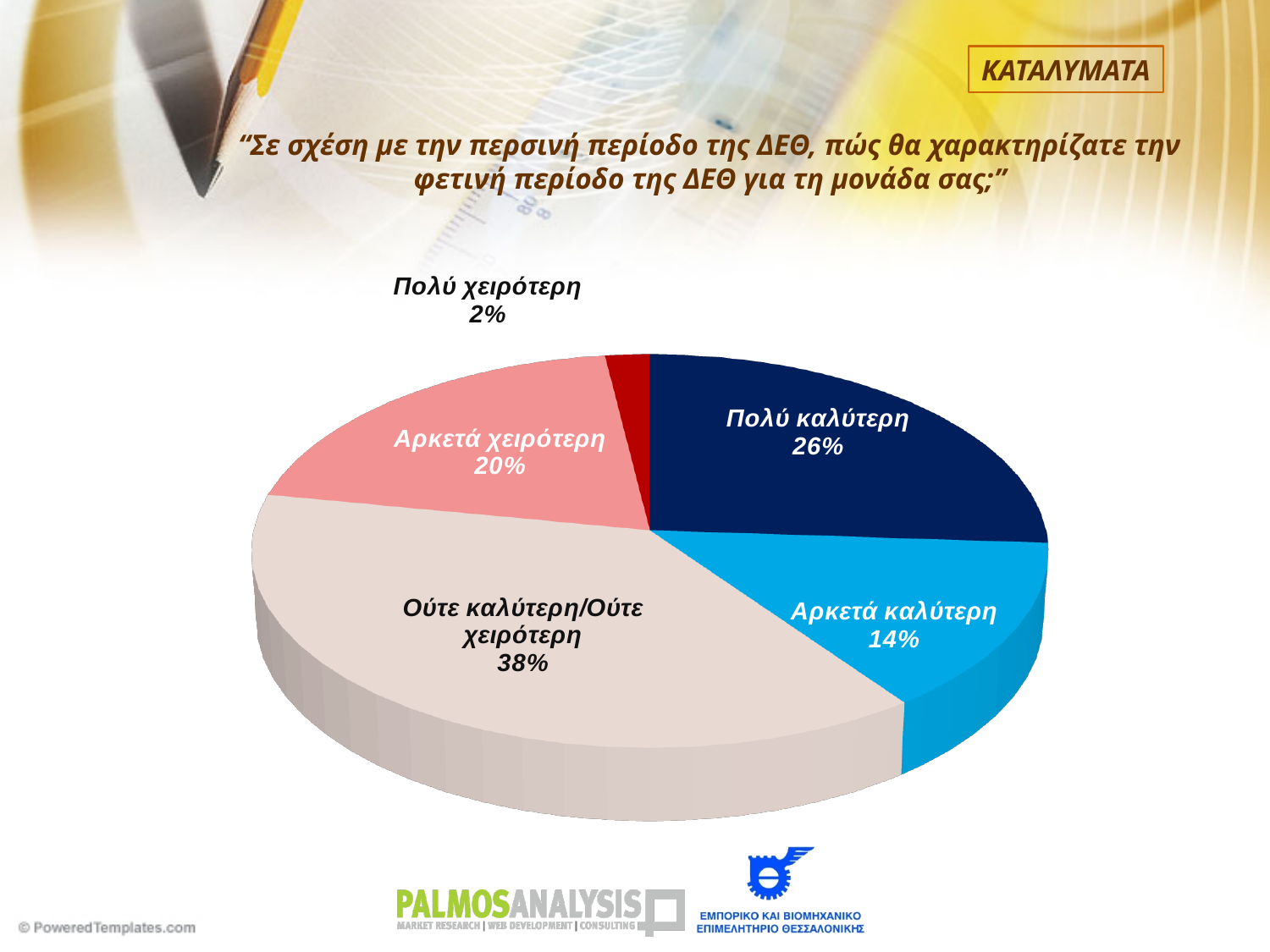
What is the value for 'Πολύ χειρότερη'? 2% What share of the pie does 'Ούτε καλύτερη/Ούτε χειρότερη' have? 38% What is the difference between 'Πολύ καλύτερη' and 'Αρκετά καλύτερη'? 12% Which is larger, 'Αρκετά χειρότερη' or 'Αρκετά καλύτερη'? Αρκετά χειρότερη Which category has the smallest slice of the pie? Πολύ χειρότερη What kind of chart is shown on the slide? pie chart What colour is the 'Πολύ καλύτερη' slice? dark blue What is the value for 'Πολύ καλύτερη'? 26% Which category has the largest slice of the pie? Ούτε καλύτερη/Ούτε χειρότερη How many categories are shown in the pie chart? 5 What is the value for 'Αρκετά χειρότερη'? 20% What is the value for 'Αρκετά καλύτερη'? 14%